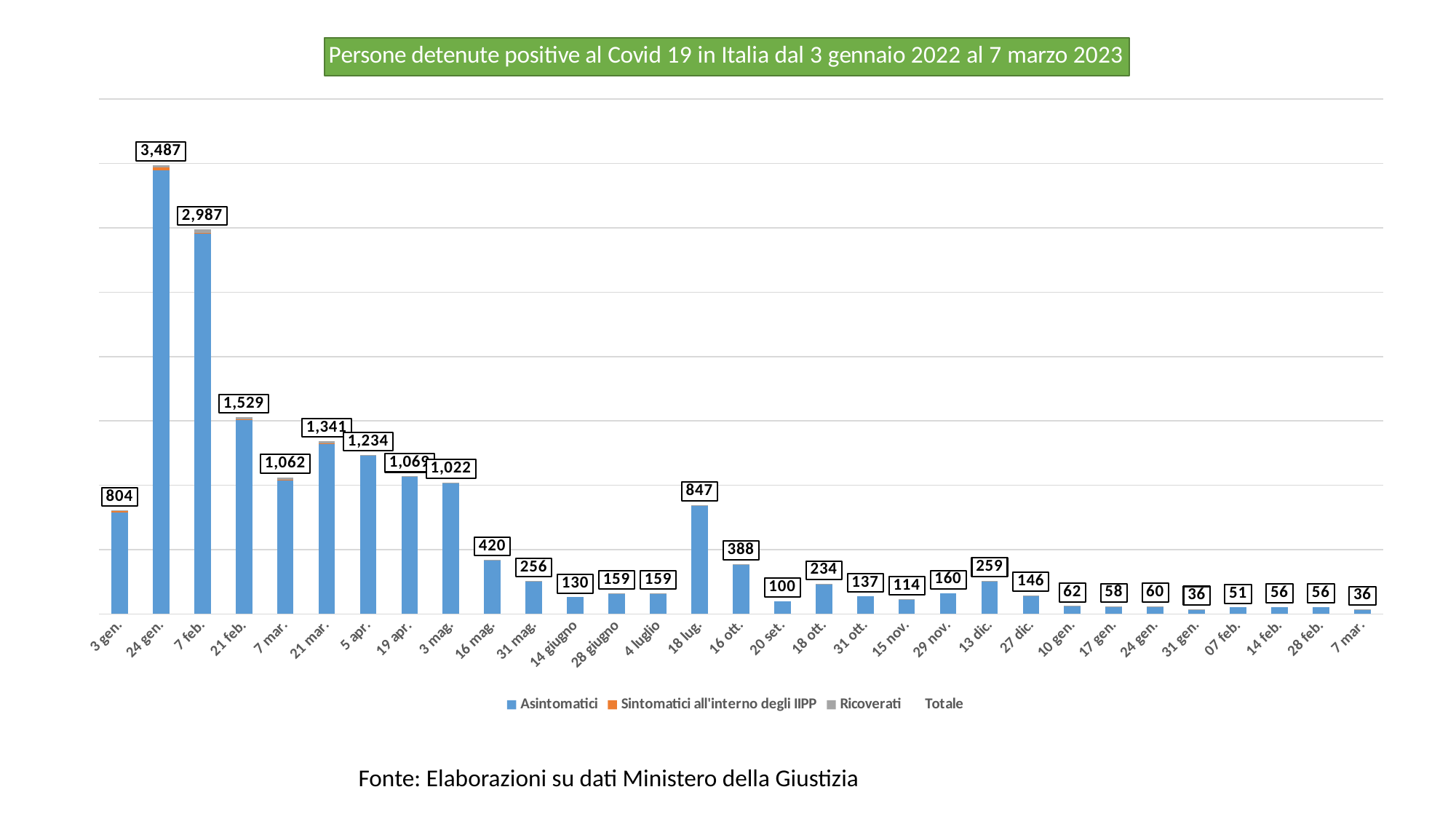
What is the total value shown for 16 mag.? 420 Which date has the highest total value? 24 gen. (the second bar) What is the difference between the totals for 18 lug. and 16 ott.? 459 What is the title of the chart? Persone detenute positive al Covid 19 in Italia dal 3 gennaio 2022 al 7 marzo 2023 What kind of chart is shown on the slide? Stacked bar chart What is the total value shown for 18 lug.? 847 How many series does the legend list? 4 What is the difference between the total for the first 24 gen. bar and the total for 7 feb.? 500 How many dates (bars) are shown on the x axis? 31 Which has a larger total, 21 mar. or 5 apr.? 21 mar. Which has a larger total, 18 ott. or 29 nov.? 18 ott. What is the total value shown for 13 dic.? 259